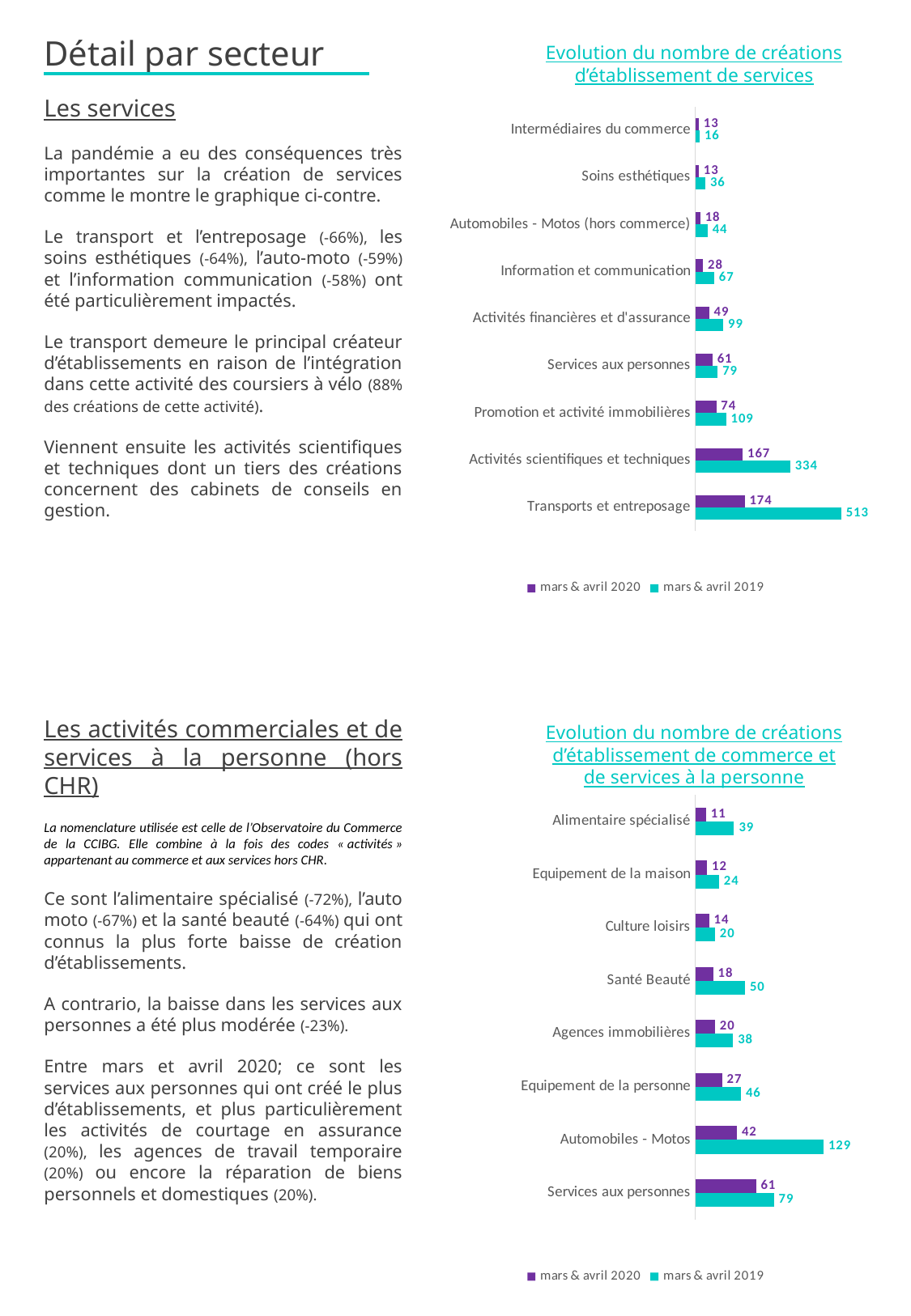
In the chart 'Evolution du nombre de créations d'établissement de services', what is the value for Soins esthétiques in mars & avril 2020? 13 In the chart 'Evolution du nombre de créations d'établissement de services', which category has the highest value for mars & avril 2020? Transports et entreposage In the chart 'Evolution du nombre de créations d'établissement de commerce et de services à la personne', what is the difference between the mars & avril 2019 and mars & avril 2020 values for Services aux personnes? 18 What kind of chart is 'Evolution du nombre de créations d'établissement de services'? Bar chart In the chart 'Evolution du nombre de créations d'établissement de commerce et de services à la personne', which is larger: the mars & avril 2019 value for Santé Beauté or for Equipement de la personne? Santé Beauté In the chart 'Evolution du nombre de créations d'établissement de services', what is the difference between the mars & avril 2019 and mars & avril 2020 values for Activités scientifiques et techniques? 167 In the chart 'Evolution du nombre de créations d'établissement de services', how many categories are shown? 9 In the chart 'Evolution du nombre de créations d'établissement de commerce et de services à la personne', what is the value for Automobiles - Motos in mars & avril 2019? 129 In the chart 'Evolution du nombre de créations d'établissement de services', what is the value for Transports et entreposage in mars & avril 2019? 513 In the chart 'Evolution du nombre de créations d'établissement de commerce et de services à la personne', how many categories are shown? 8 In the chart 'Evolution du nombre de créations d'établissement de services', how many series does the legend list? 2 In the chart 'Evolution du nombre de créations d'établissement de commerce et de services à la personne', which category has the lowest value for mars & avril 2020? Alimentaire spécialisé